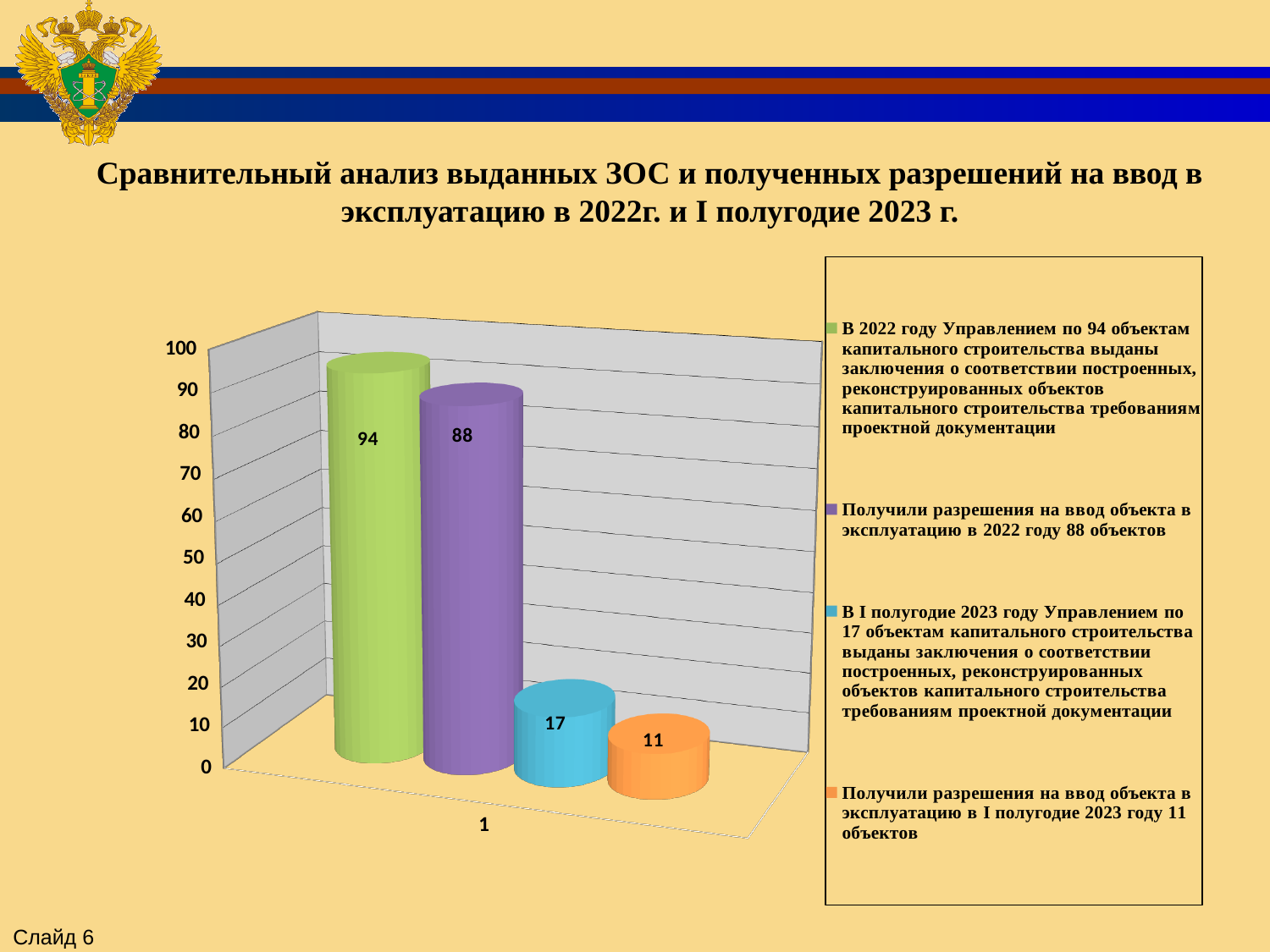
Какой показатель на диаграмме имеет наименьшее значение? Разрешения на ввод в эксплуатацию в I полугодии 2023 года (11) На сколько число выданных ЗОС в 2022 году превышает число полученных разрешений на ввод в 2022 году? 6 Какой показатель на диаграмме имеет наибольшее значение? Выданные ЗОС в 2022 году (94) На сколько число выданных ЗОС в I полугодии 2023 года больше числа полученных разрешений на ввод в I полугодии 2023 года? 6 Сколько рядов данных перечислено в легенде диаграммы? 4 Сколько заключений о соответствии выдано в I полугодии 2023 года согласно диаграмме? 17 Сколько разрешений на ввод объекта в эксплуатацию получено в 2022 году согласно диаграмме? 88 Сколько разрешений на ввод объекта в эксплуатацию получено в I полугодии 2023 года согласно диаграмме? 11 Каким цветом на диаграмме показаны разрешения на ввод объекта в эксплуатацию в 2022 году? Фиолетовым Сколько заключений о соответствии (ЗОС) выдано Управлением в 2022 году согласно диаграмме? 94 Что больше: число выданных ЗОС в 2022 году или число полученных разрешений на ввод в 2022 году? Число выданных ЗОС в 2022 году (94) Какого типа диаграмма представлена на слайде? Столбчатая (bar chart)